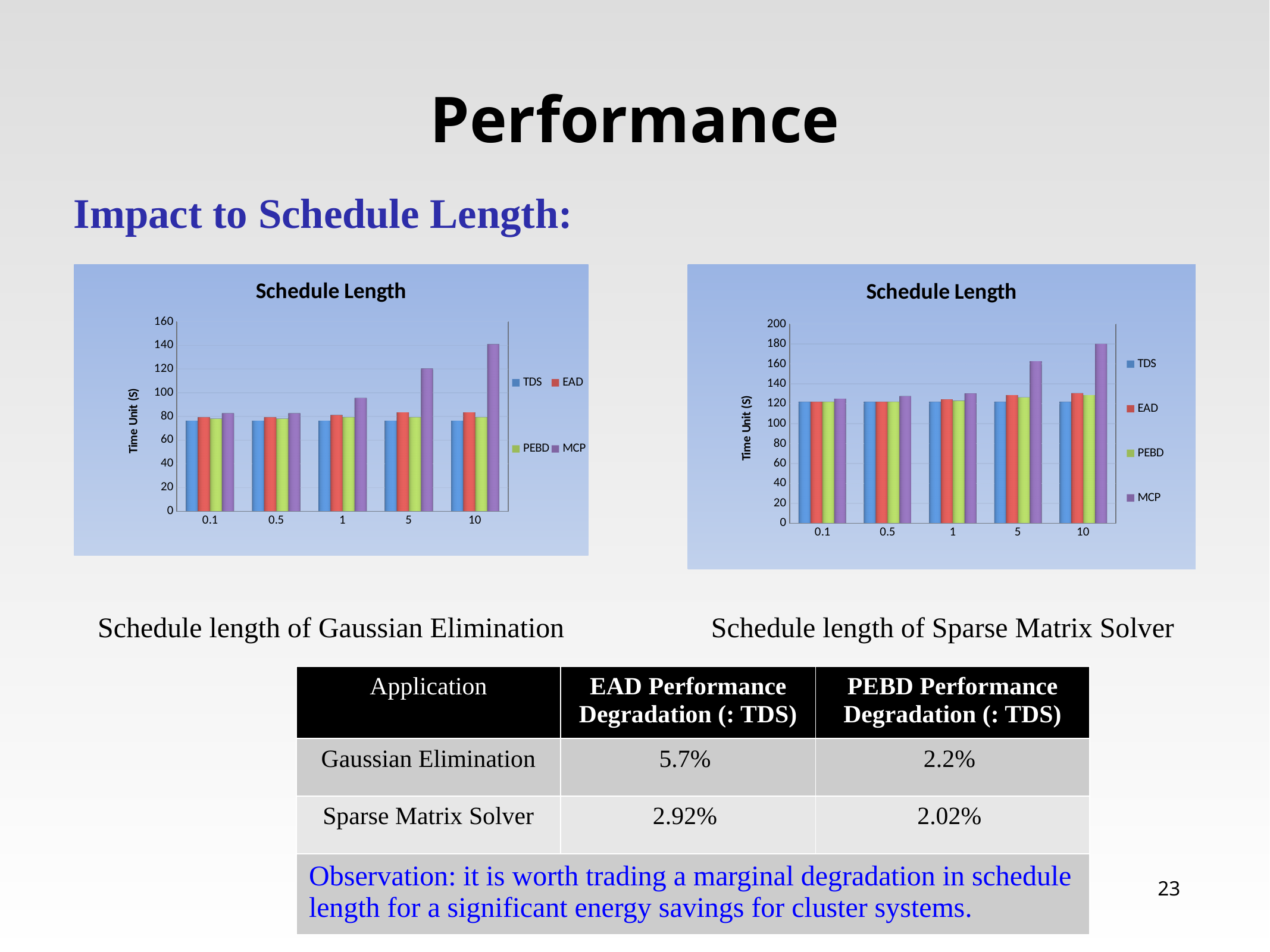
In the left chart (Schedule length of Gaussian Elimination), which series has the highest value at category 10? MCP What is the title of the right chart (Schedule length of Sparse Matrix Solver)? Schedule Length In the right chart (Schedule length of Sparse Matrix Solver), which category has the larger MCP value, 0.1 or 10? 10 What is the y-axis label of the left chart (Schedule length of Gaussian Elimination)? Time Unit ($) In the right chart (Schedule length of Sparse Matrix Solver), is the MCP value at category 5 greater or less than 140? greater What kind of chart is the left chart (Schedule length of Gaussian Elimination)? bar chart In the left chart (Schedule length of Gaussian Elimination), how many categories are shown on the x axis? 5 In the left chart (Schedule length of Gaussian Elimination), do the MCP values rise or fall as you move from 0.1 to 10 along the x axis? rise In the left chart (Schedule length of Gaussian Elimination), is the MCP value at category 10 greater or less than 120? greater In the right chart (Schedule length of Sparse Matrix Solver), how many series does the legend list? 4 In the left chart (Schedule length of Gaussian Elimination), is the TDS value at category 0.1 greater or less than 80? less